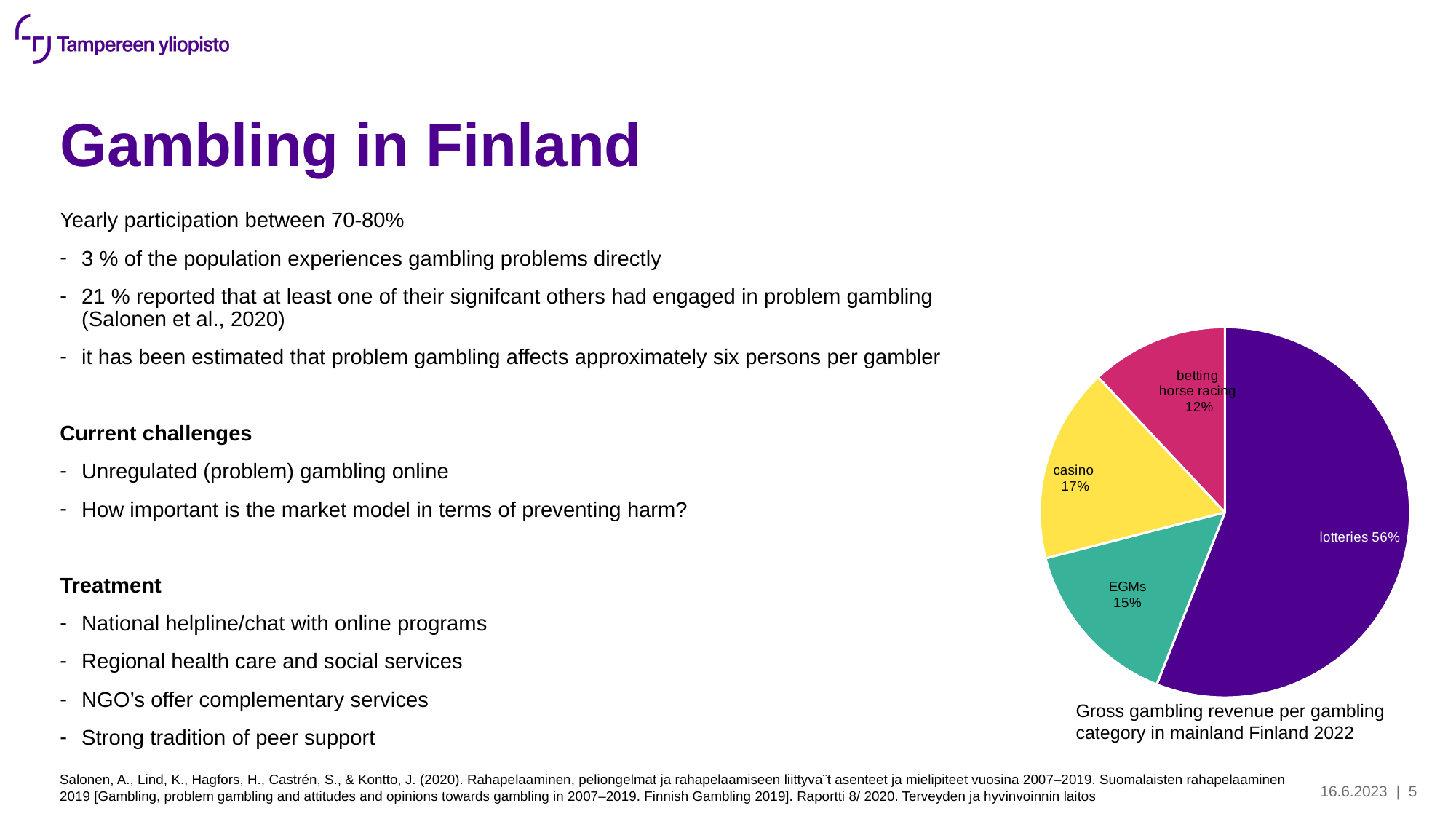
What is the caption of the pie chart? Gross gambling revenue per gambling category in mainland Finland 2022 What is the difference in percentage points between casino and EGMs? 2 How many categories are shown in the pie chart? 4 What percentage is shown for betting horse racing? 12% Which gambling category has the smallest share of gross gambling revenue? betting horse racing What is the difference in percentage points between lotteries and casino? 39 What share of gross gambling revenue do lotteries account for? 56% What percentage is shown for casino? 17% What percentage is shown for EGMs? 15% Which has a larger share, casino or betting horse racing? casino What type of chart is shown on the slide? pie chart Which gambling category has the largest share of gross gambling revenue? lotteries